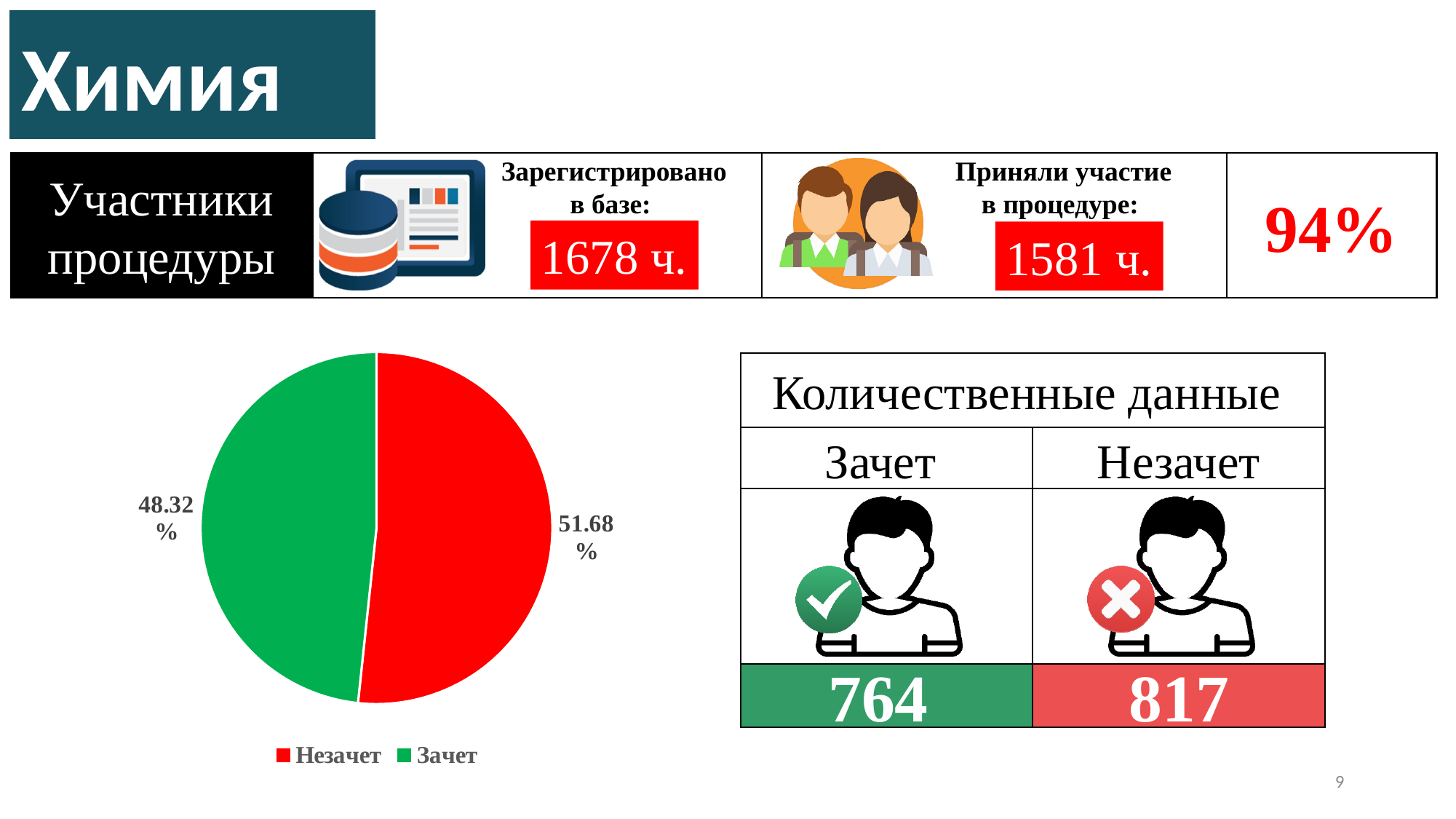
Which slice of the pie chart is the largest? Незачет What percentage does the pie chart show for Незачет? 51.68% What kind of chart is shown on the slide? pie chart How many entries does the pie chart legend list? 2 Which slice of the pie chart is the smallest? Зачет What percentage does the pie chart show for Зачет? 48.32% What colour is the Зачет slice in the pie chart? green What is the difference in percentage points between the Незачет and Зачет slices? 3.36 Which is larger in the pie chart, Незачет or Зачет? Незачет How many slices does the pie chart have? 2 What colour is the Незачет slice in the pie chart? red